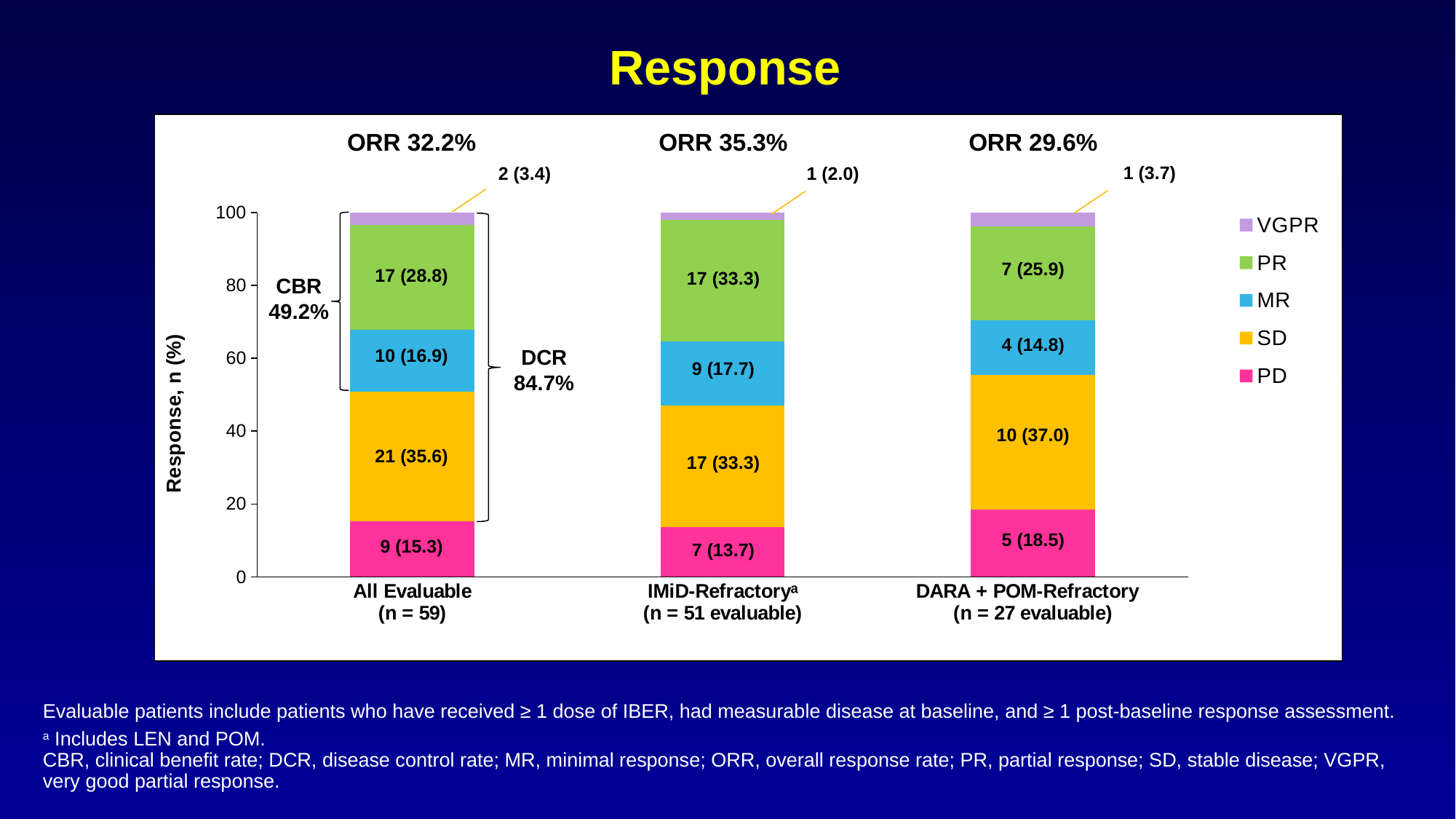
How many patient groups are shown on the x axis? 3 What is the SD value shown for the DARA + POM-Refractory group? 10 (37.0) Which response category is the largest segment in the All Evaluable bar? SD What ORR is shown above the IMiD-Refractory bar? ORR 35.3% What is the PR value shown for the All Evaluable group? 17 (28.8) What is the VGPR value shown for the All Evaluable group? 2 (3.4) What type of chart is shown on the slide? Stacked bar chart Which group has more MR patients, IMiD-Refractory or DARA + POM-Refractory? IMiD-Refractory Which group has the lowest number of PD patients? DARA + POM-Refractory How many response categories does the legend list? 5 What is the PD value shown for the IMiD-Refractory group? 7 (13.7) How many more PR patients are in the All Evaluable group than in the DARA + POM-Refractory group? 10